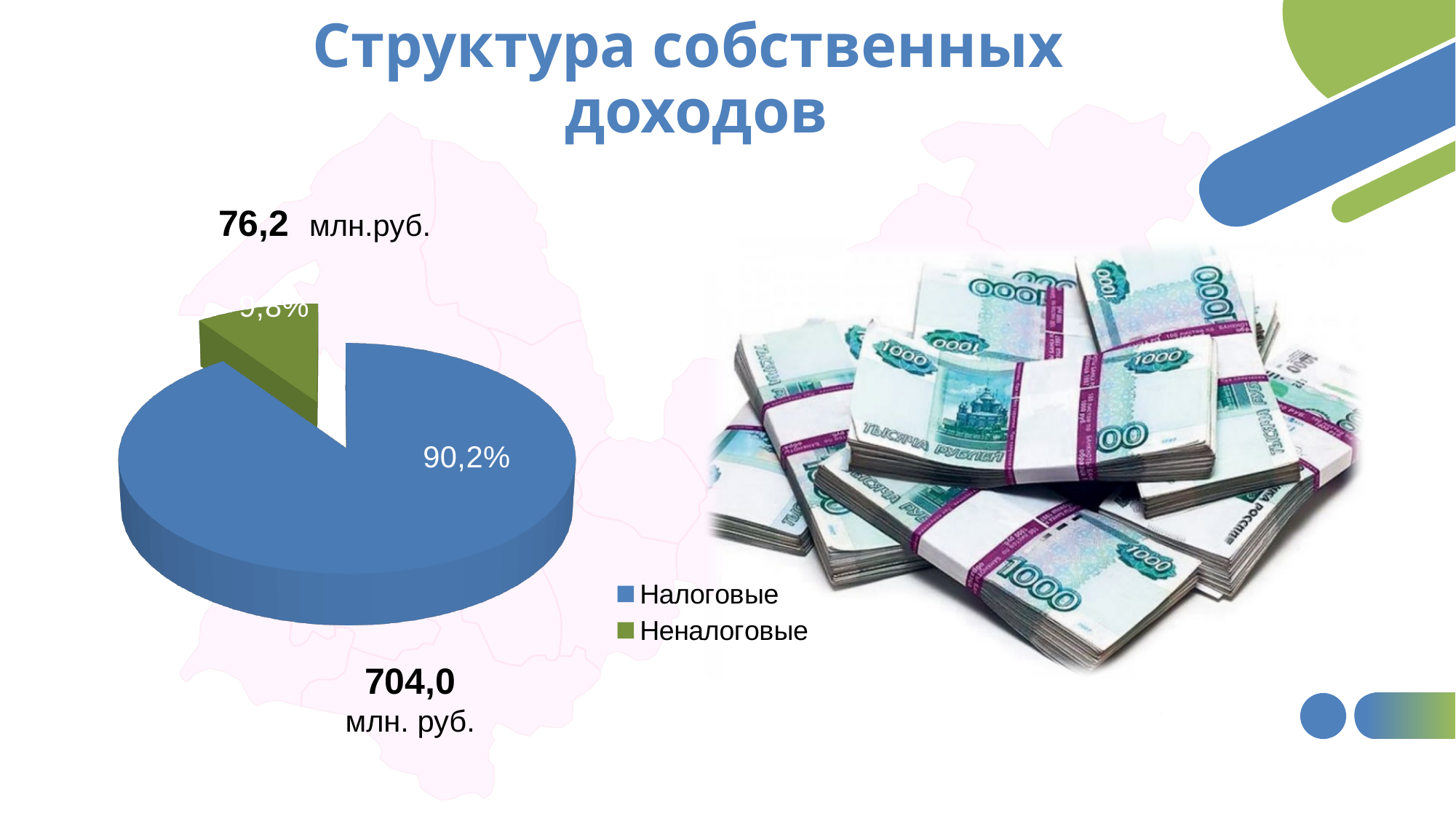
What share of the pie does the Неналоговые slice represent? 9,8% How many slices does the pie chart have? 2 What share of the pie does the Налоговые slice represent? 90,2% What kind of chart is shown on the slide? pie chart How many entries does the legend of the pie chart list? 2 Which slice of the pie chart is the smallest? Неналоговые Which slice of the pie chart is the largest? Налоговые What is the difference in percentage points between the Налоговые and Неналоговые slices? 80,4 What amount in млн.руб. is shown next to the Неналоговые slice? 76,2 Which is larger, the Налоговые slice or the Неналоговые slice? Налоговые What amount in млн. руб. is shown next to the Налоговые slice? 704,0 What colour is the Неналоговые slice in the pie chart? green